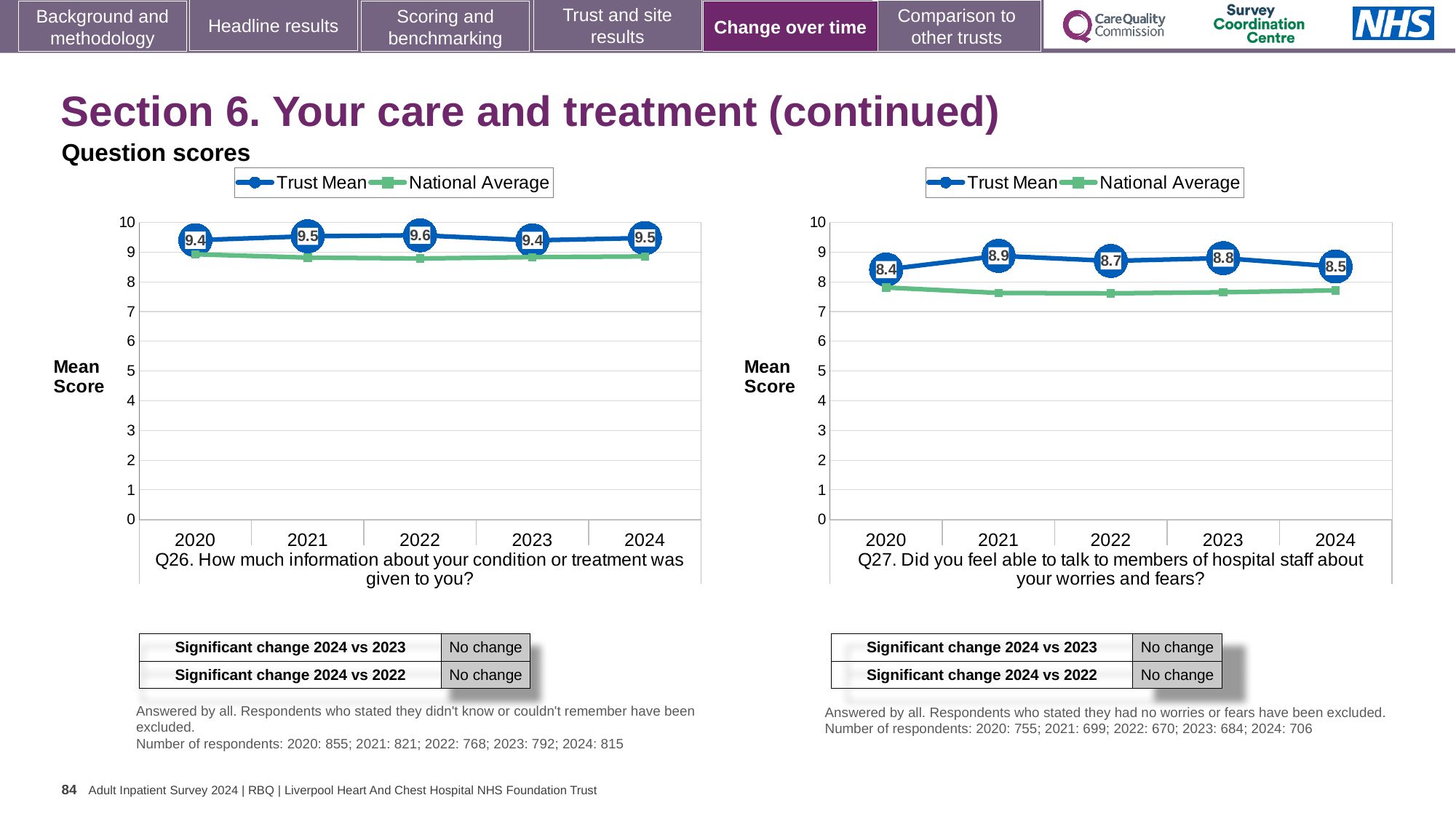
What kind of chart is the Q26 chart (left)? Line chart In the Q27 chart (right), is the National Average value for 2022 greater or less than 8? less In the Q26 chart (left), is the National Average value for 2021 greater or less than 9? less In the Q27 chart (right), which year has the lowest Trust Mean score? 2020 In the Q26 chart (left), what is the Trust Mean score for 2022? 9.6 In the Q27 chart (right), what is the difference between the Trust Mean scores for 2021 and 2024? 0.4 How many series does the legend of the Q27 chart (right) list? 2 In the Q26 chart (left), what is the difference between the Trust Mean scores for 2022 and 2023? 0.2 In the Q27 chart (right), which is larger: the Trust Mean for 2021 or the Trust Mean for 2024? 2021 In the Q27 chart (right), which year has the highest Trust Mean score? 2021 In the Q27 chart (right), what is the Trust Mean score for 2020? 8.4 How many years are shown on the x axis of the Q26 chart (left)? 5